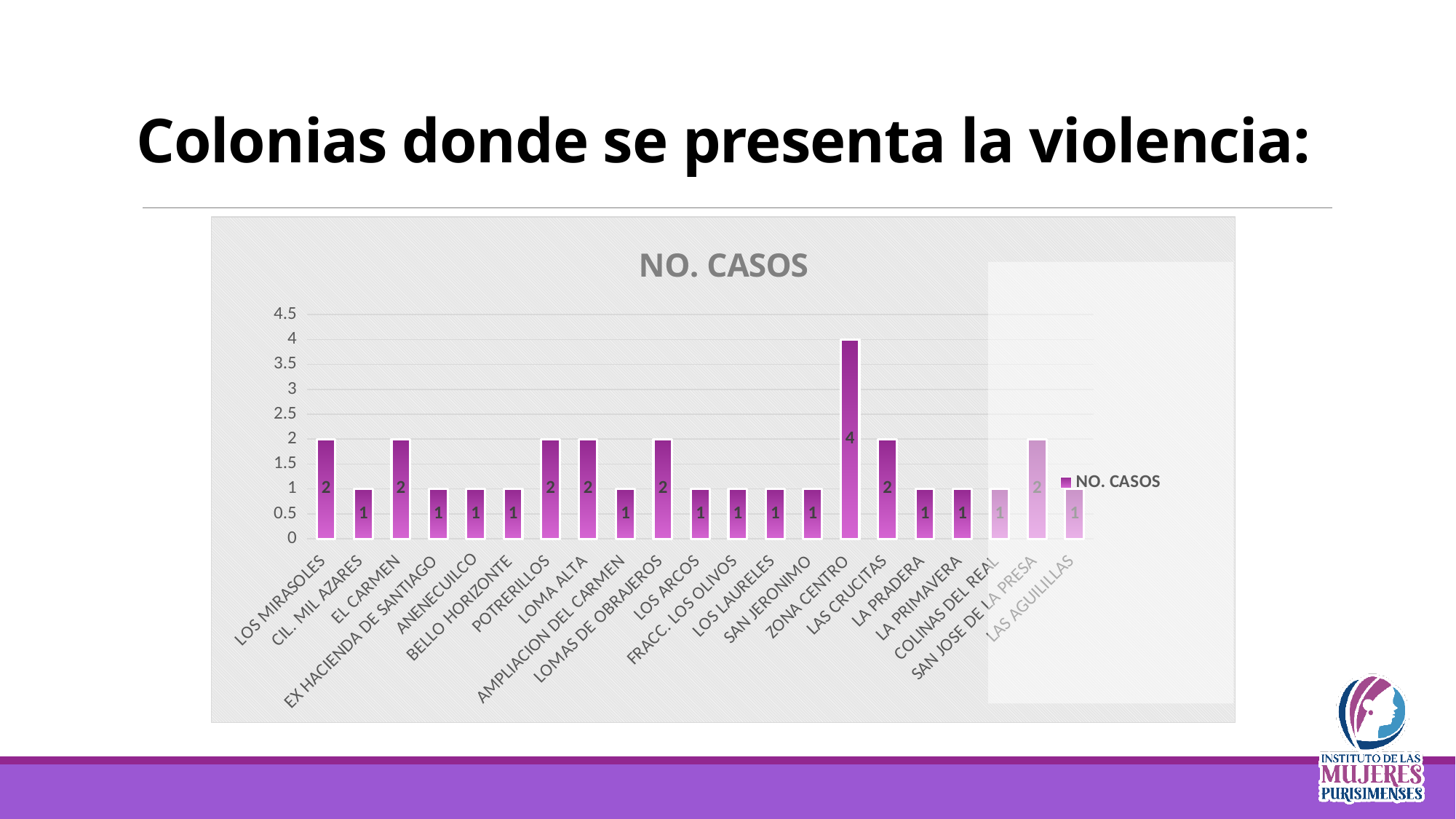
What is the value for ZONA CENTRO? 4 Which is larger, the value for EL CARMEN or the value for ANENECUILCO? EL CARMEN What kind of chart is shown on the slide? bar chart What is the value for LOS MIRASOLES? 2 How many series does the legend list? 1 What is the difference between the values for ZONA CENTRO and LAS CRUCITAS? 2 Is the value for ZONA CENTRO greater or less than 3? greater Which colonia has the highest number of cases? ZONA CENTRO How many colonias are shown on the x axis? 21 What is the value for SAN JERONIMO? 1 What is the title of the chart? NO. CASOS What is the value for SAN JOSE DE LA PRESA? 2